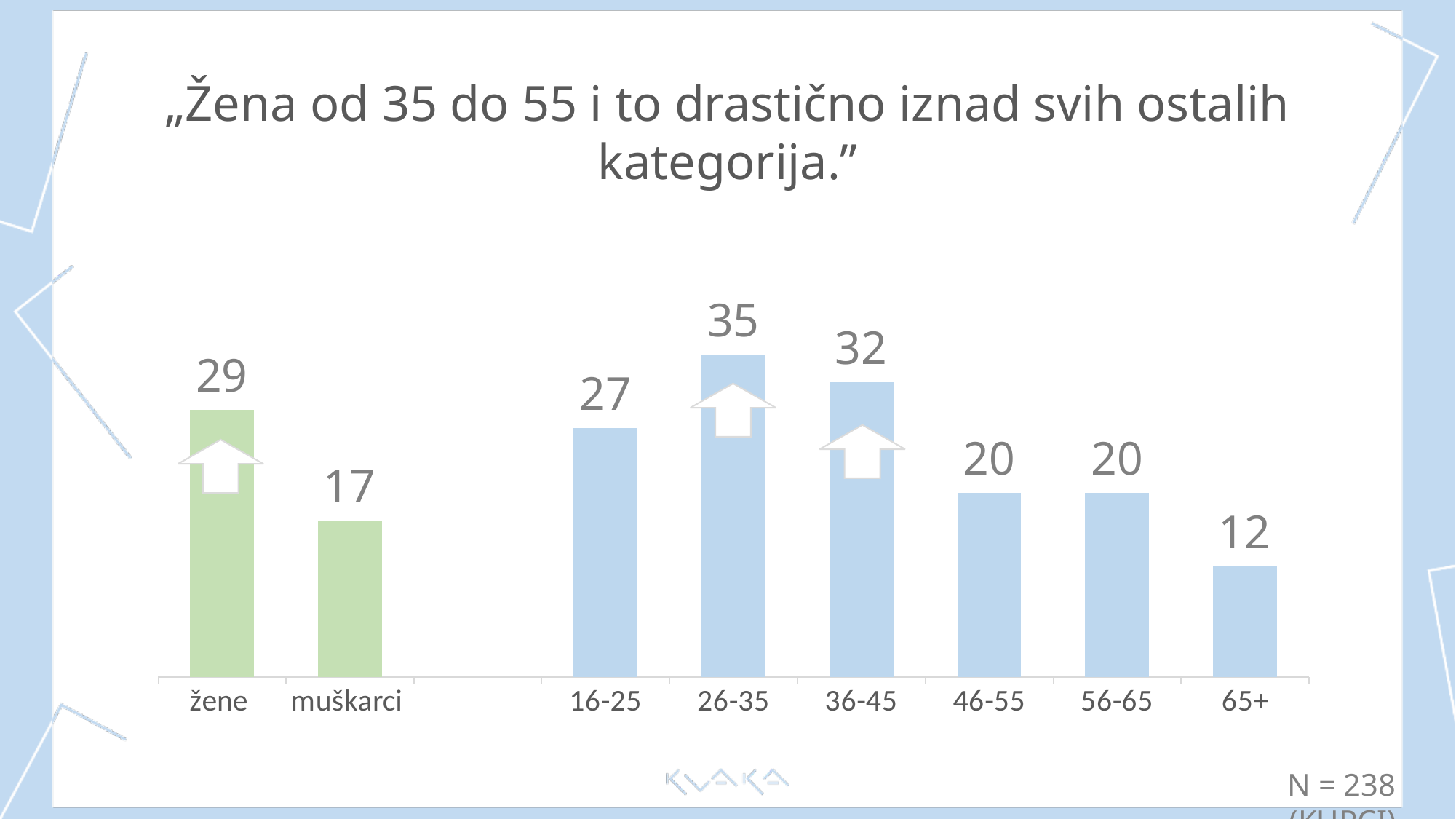
What kind of chart is shown on the slide? bar chart Which age group has the highest value? 26-35 Which age group has the lowest value? 65+ What is the difference between the values for žene and muškarci? 12 Which is larger, the value for 16-25 or the value for 46-55? 16-25 What is the value for muškarci? 17 What is the difference between the values for the 26-35 and 36-45 age groups? 3 Do the values fall or rise from the 36-45 age group to the 65+ age group? fall How many age group categories are shown on the chart? 6 What is the value for the 65+ age group? 12 What is the value for žene? 29 What is the value for the 26-35 age group? 35